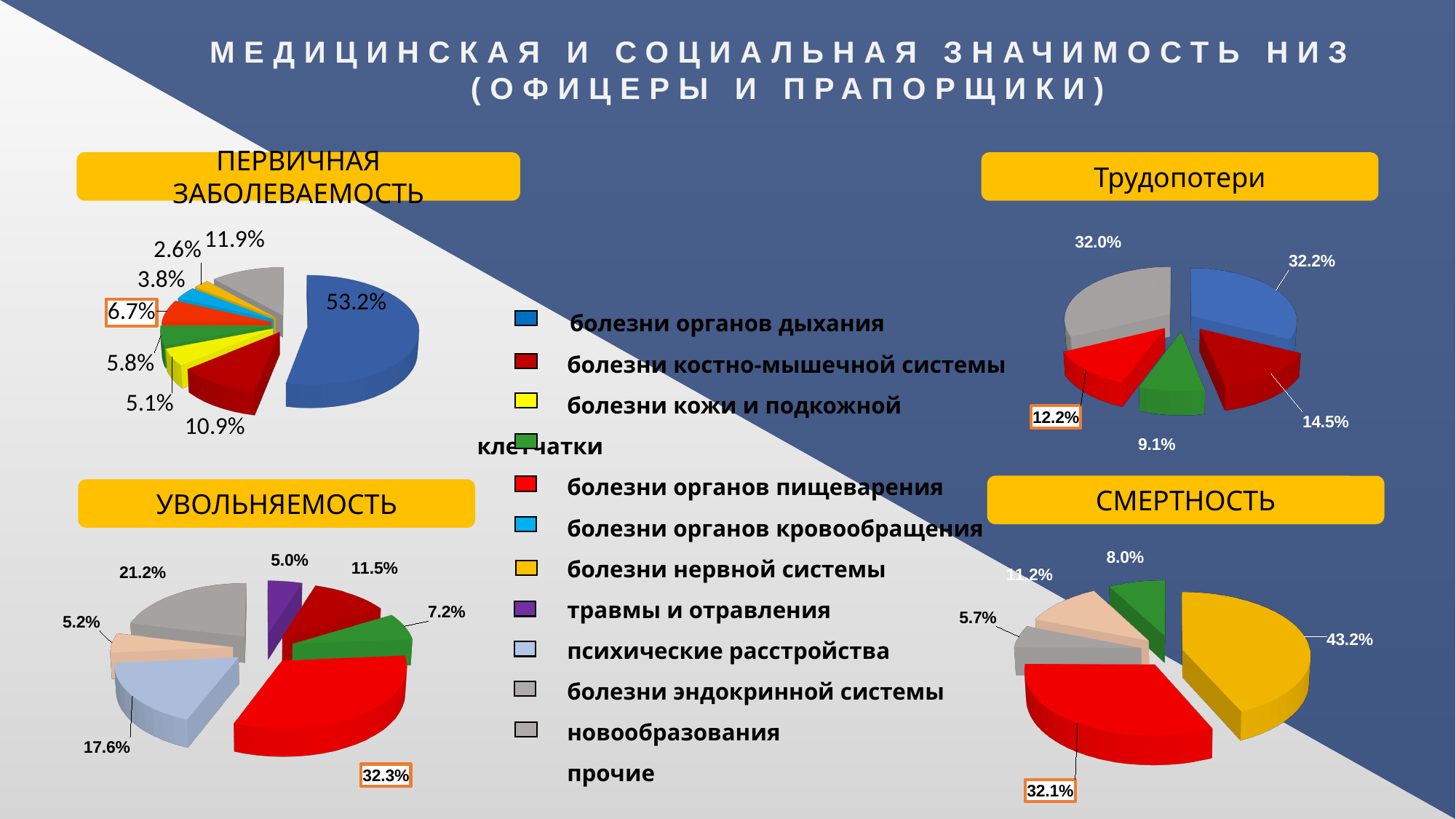
In the Трудопотери chart, what value is shown in the orange highlighted box? 12.2% In the СМЕРТНОСТЬ chart, what colour is the largest slice? Yellow What kind of charts are shown on the slide? Pie charts In the Трудопотери chart, what is the difference between the 14.5% slice and the 9.1% slice? 5.4 percentage points In the СМЕРТНОСТЬ chart, what is the value of the largest slice? 43.2% In the УВОЛЬНЯЕМОСТЬ chart, what value is shown in the orange highlighted box? 32.3% How many slices does the УВОЛЬНЯЕМОСТЬ pie chart have? 7 How many slices does the Трудопотери pie chart have? 5 In the ПЕРВИЧНАЯ ЗАБОЛЕВАЕМОСТЬ chart, what is the value of the smallest slice? 2.6% In the СМЕРТНОСТЬ chart, what is the difference between the largest slice (43.2%) and the highlighted slice (32.1%)? 11.1 percentage points In the УВОЛЬНЯЕМОСТЬ chart, which is larger: the 21.2% slice or the 17.6% slice? 21.2% In the ПЕРВИЧНАЯ ЗАБОЛЕВАЕМОСТЬ chart, what is the value of the largest slice? 53.2%